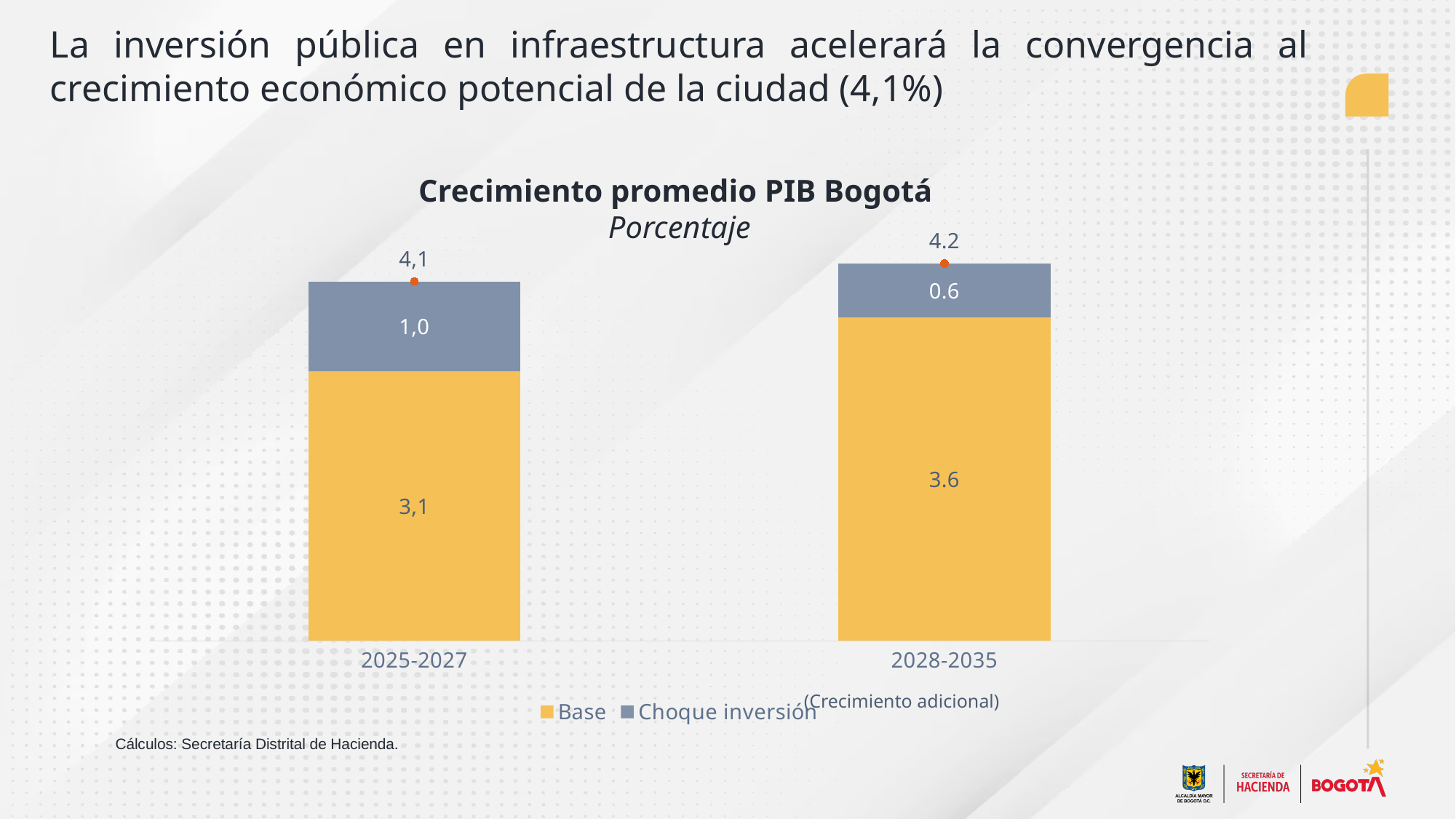
Which period has the higher Base value, 2025-2027 or 2028-2035? 2028-2035 What is the total of the stacked bar for 2025-2027? 4,1 What is the Choque inversión value for 2028-2035? 0.6 What is the Base value for 2025-2027? 3,1 What is the Base value for 2028-2035? 3.6 What kind of chart is shown on the slide? Stacked bar chart Which period has the lower Choque inversión value? 2028-2035 How many series does the legend list? 2 What is the Choque inversión value for 2025-2027? 1,0 What is the difference between the Base values for 2028-2035 and 2025-2027? 0.5 How many periods (categories) are shown on the x axis? 2 What is the total of the stacked bar for 2028-2035? 4.2